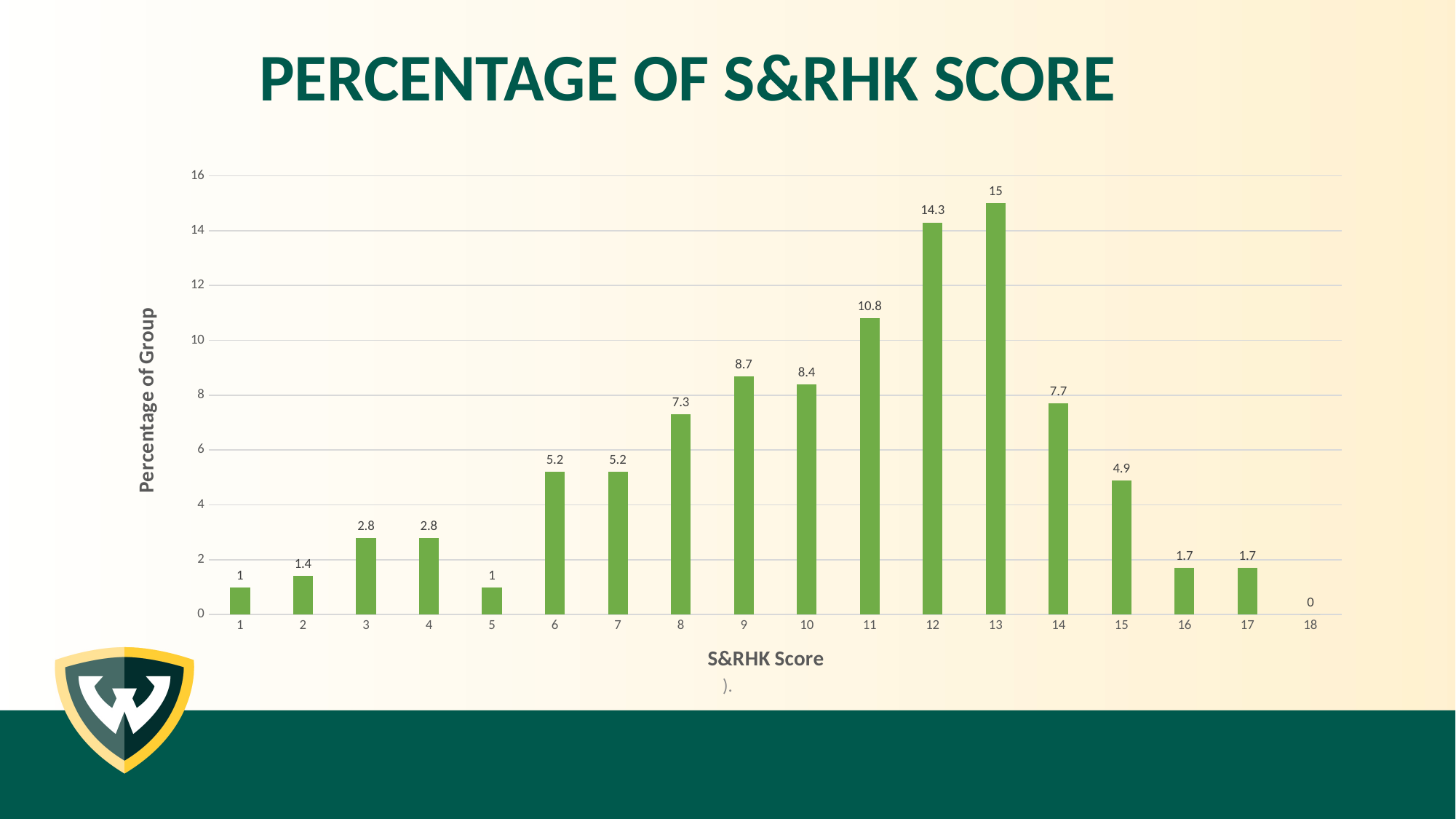
Which S&RHK score has the highest percentage of the group? 13 What is the difference between the percentage for score 13 and the percentage for score 12? 0.7 What is the percentage of the group with an S&RHK score of 18? 0 Which has a larger percentage of the group: S&RHK score 9 or score 10? 9 What is the percentage of the group with an S&RHK score of 12? 14.3 What is the difference between the percentage for score 11 and the percentage for score 14? 3.1 How many S&RHK score categories are shown on the x axis? 18 Which S&RHK score has the lowest percentage of the group? 18 What is the percentage of the group with an S&RHK score of 9? 8.7 What kind of chart is shown on the slide? Bar chart What is the label of the y axis? Percentage of Group Is the value for S&RHK score 8 greater or less than 6? greater